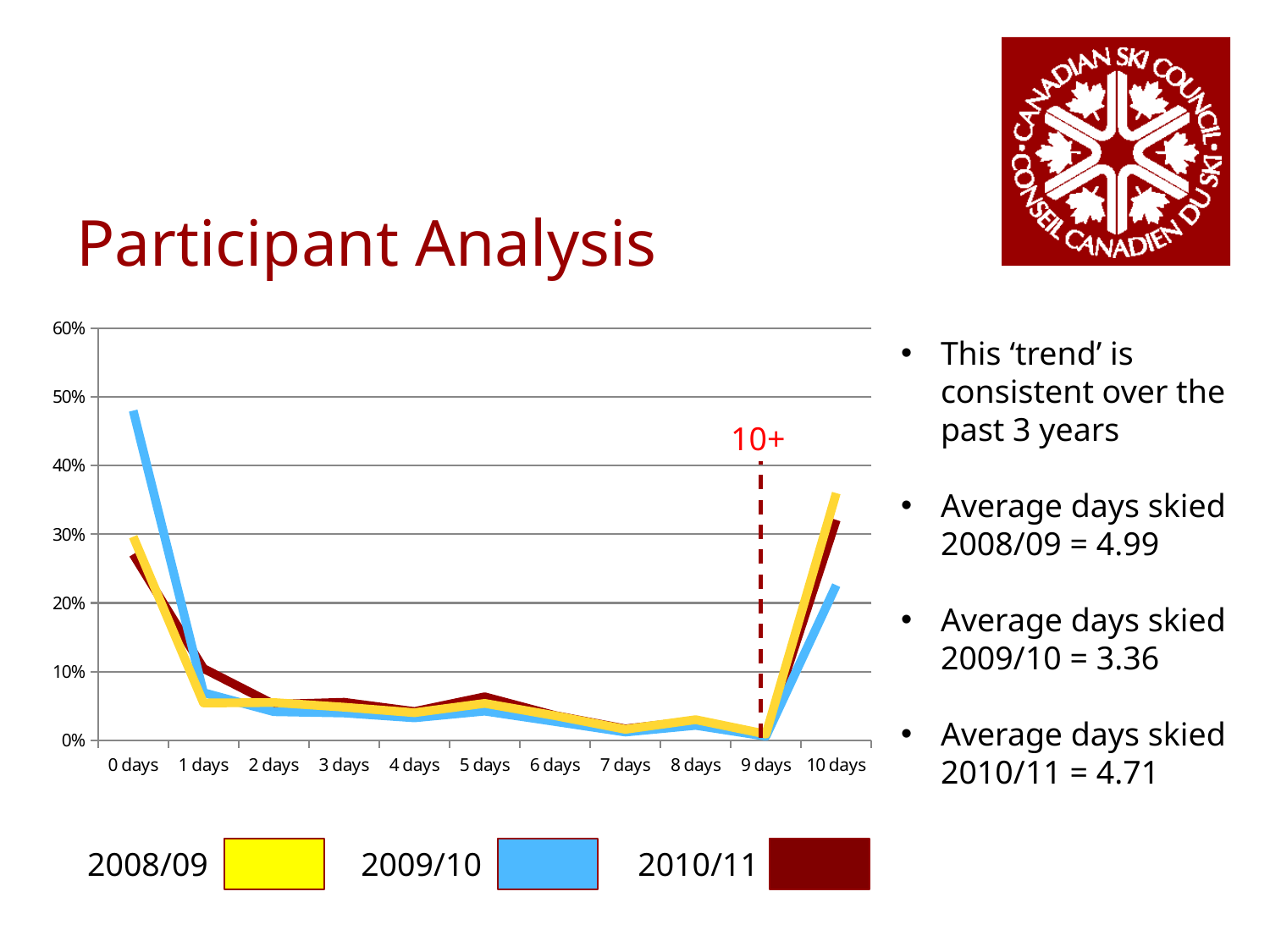
Does the 2009/10 line rise or fall from 0 days to 1 days? fall How many categories are shown on the x axis of the chart? 11 At 10 days, which series has the larger value: 2008/09 or 2009/10? 2008/09 At 0 days, which series has the larger value: 2009/10 or 2008/09? 2009/10 How many series does the legend list? 3 Is the value for 2010/11 at 10 days greater or less than 20%? greater Is the value for 2009/10 at 10 days greater or less than 30%? less For the 2009/10 series, which category has the highest value? 0 days What label is written next to the dashed vertical line on the chart? 10+ Is the value for 2008/09 at 0 days greater or less than 40%? less What kind of chart is shown on the slide? line chart